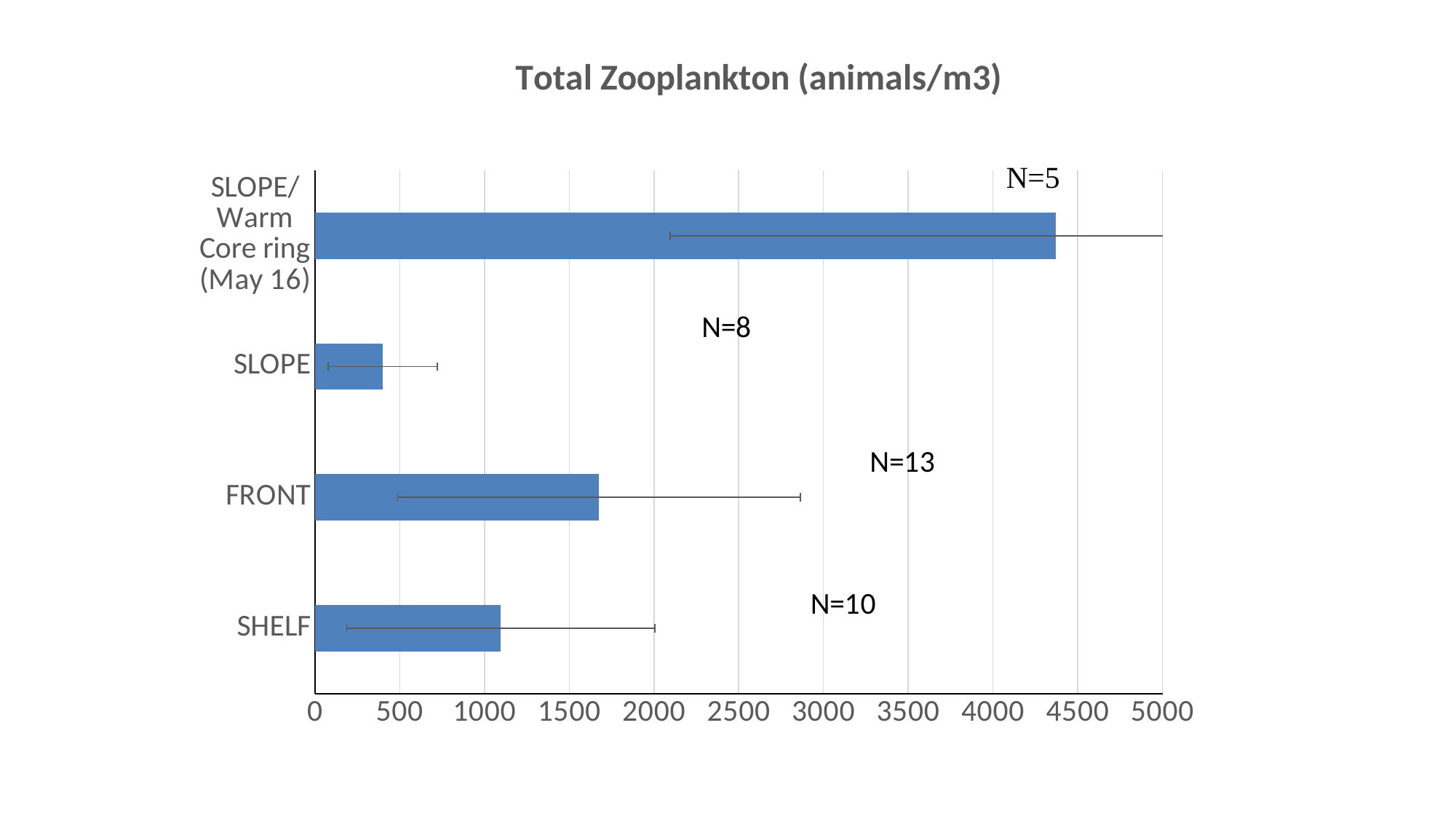
Which has a larger total zooplankton value, FRONT or SHELF? FRONT Which category has the highest total zooplankton value? SLOPE/Warm Core ring (May 16) What is the title of the chart? Total Zooplankton (animals/m3) What kind of chart is shown on the slide? bar chart How many categories are plotted in the chart? 4 Which category has the lowest total zooplankton value? SLOPE What sample size (N) is annotated next to the FRONT bar? N=13 Is the value for SLOPE greater or less than 500? less Is the value for SLOPE/Warm Core ring (May 16) greater or less than 4000? greater Which has a larger total zooplankton value, SLOPE or SHELF? SHELF Is the value for SHELF greater or less than 1500? less